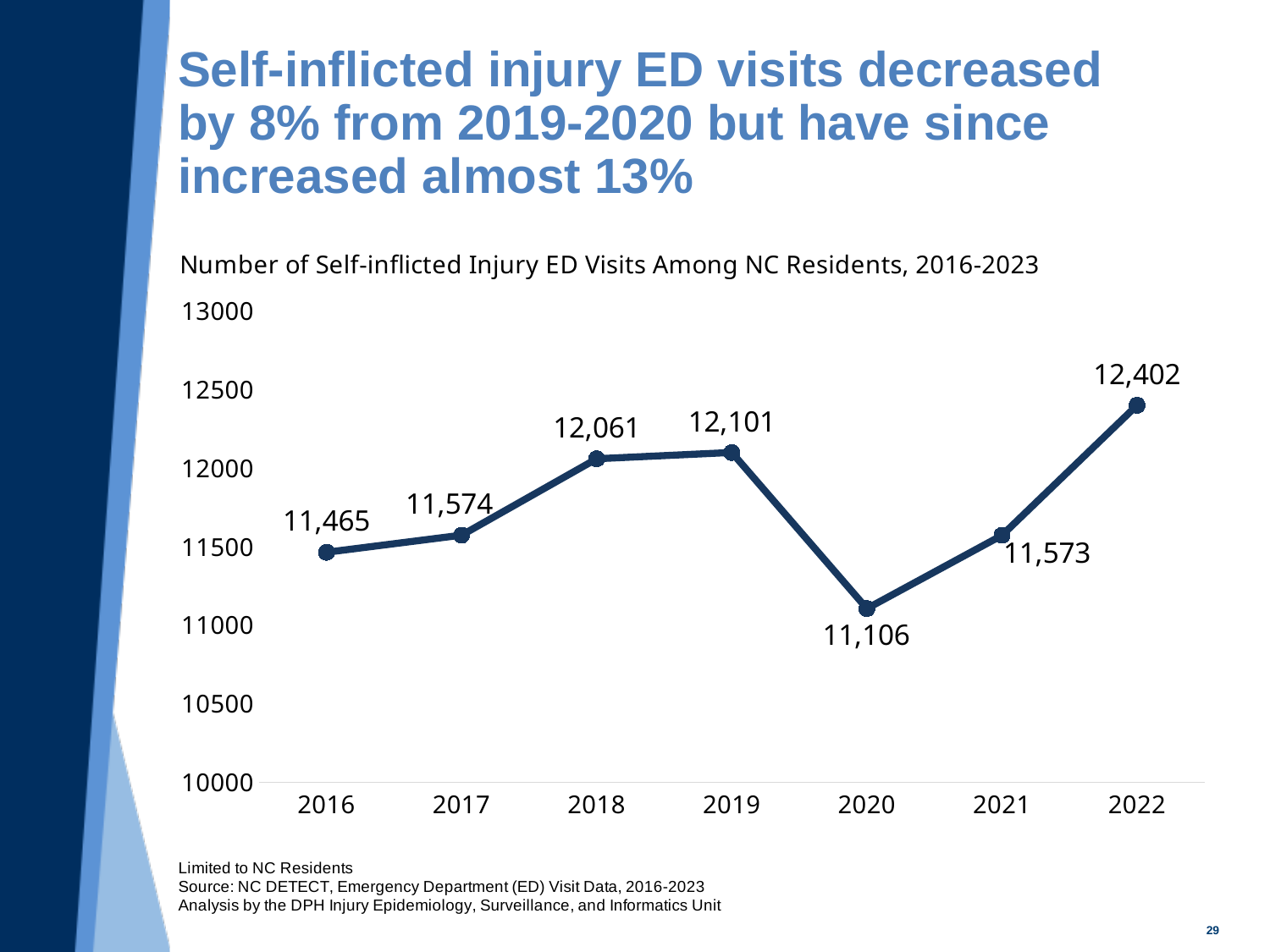
What is the number of self-inflicted injury ED visits in 2016? 11,465 Is the value for 2020 greater or less than 11500? less What type of chart is shown on the slide? line chart Which year has the highest number of self-inflicted injury ED visits? 2022 What is the number of self-inflicted injury ED visits in 2022? 12,402 What is the title of the chart? Number of Self-inflicted Injury ED Visits Among NC Residents, 2016-2023 What is the difference between the number of ED visits in 2019 and in 2018? 40 What is the number of self-inflicted injury ED visits in 2020? 11,106 How many years are plotted on the chart? 7 Which year had more self-inflicted injury ED visits, 2018 or 2020? 2018 Which year has the lowest number of self-inflicted injury ED visits? 2020 What is the difference between the number of ED visits in 2022 and in 2020? 1,296